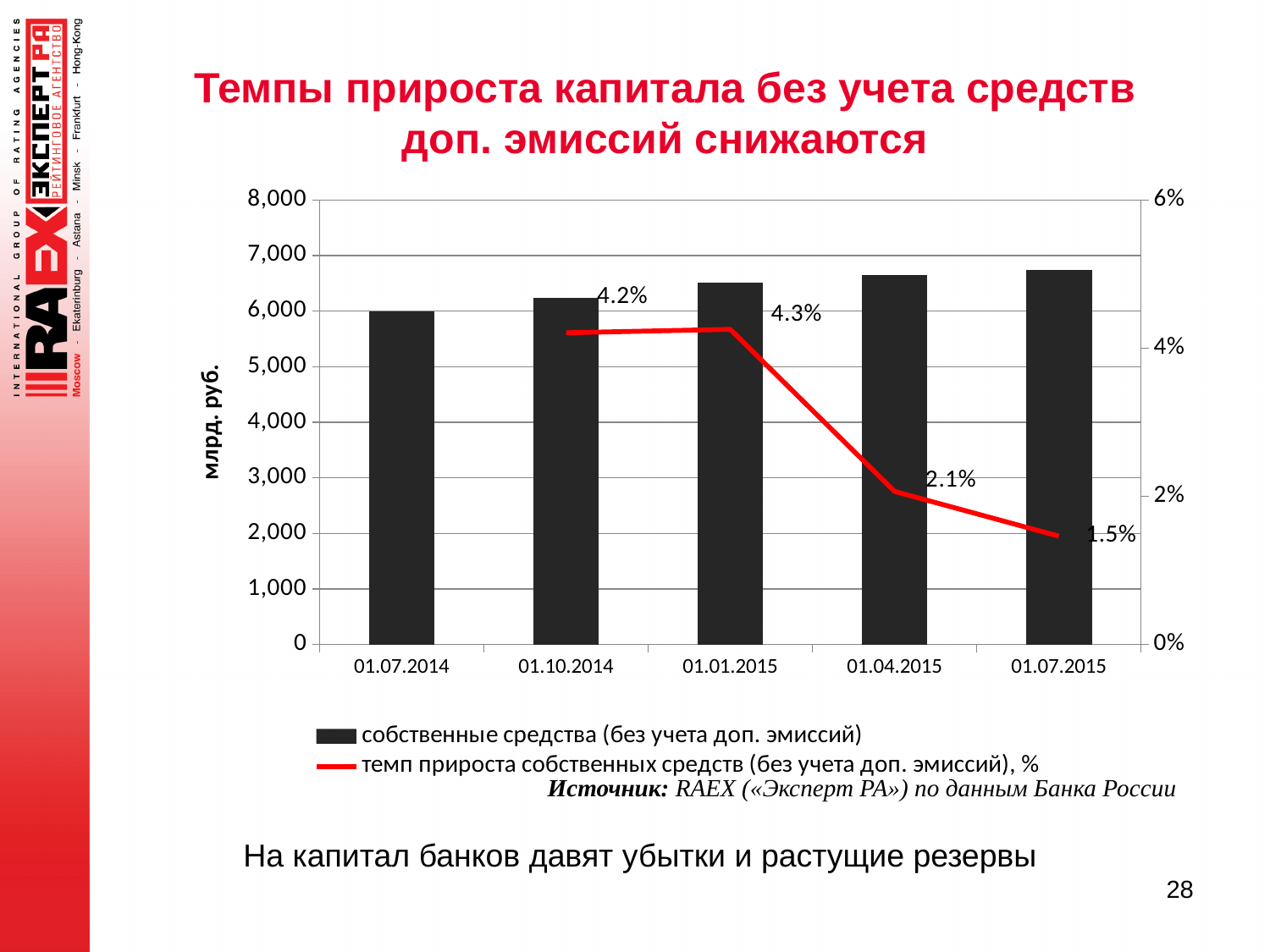
Which date has the higher growth rate of own funds: 01.10.2014 or 01.04.2015? 01.10.2014 At which date is the growth rate of own funds the lowest? 01.07.2015 What is the growth rate of own funds shown for 01.04.2015? 2.1% Is the value of own funds (собственные средства) for 01.07.2015 greater or less than 6,000? greater What is the growth rate of own funds shown for 01.07.2015? 1.5% At which date is the growth rate of own funds the highest? 01.01.2015 Do the own funds bars rise or fall from 01.07.2014 to 01.07.2015? rise How many dates are shown on the x axis of the chart? 5 What is the growth rate of own funds (темп прироста собственных средств) shown for 01.01.2015? 4.3% How many series does the chart legend list? 2 By how many percentage points does the growth rate at 01.01.2015 exceed the growth rate at 01.07.2015? 2.8 percentage points Is the value of own funds for 01.07.2014 greater or less than 7,000? less